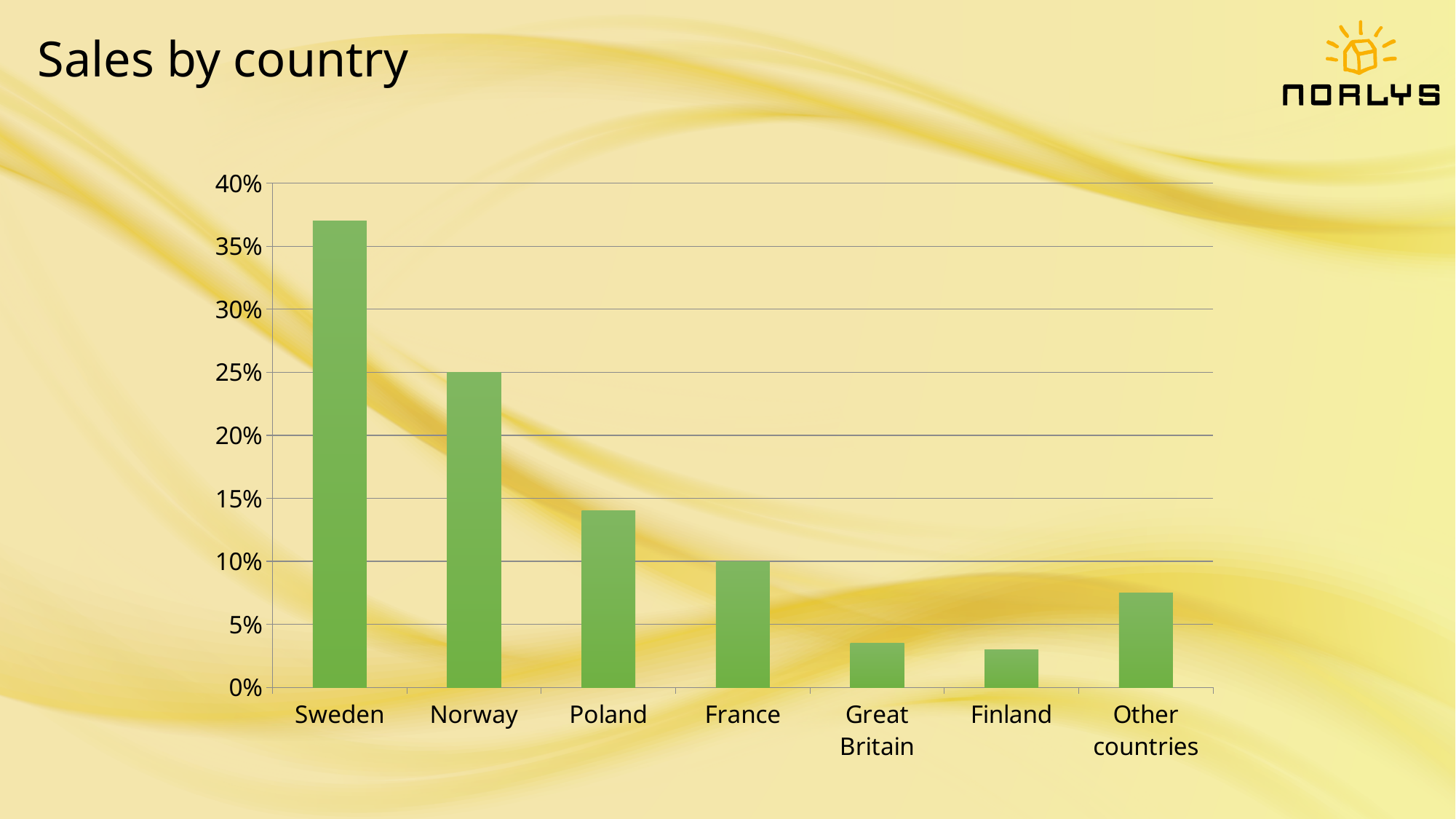
Is the value for Other countries greater or less than 5%? greater Is the value for Sweden greater or less than 35%? greater How many countries/categories are shown on the x axis? 7 What is the title of the chart? Sales by country What is the sales share for France? 10% Do the values generally rise or fall from Sweden to Finland along the x axis? fall Which is larger, the value for Poland or the value for France? Poland Which country has the highest sales share? Sweden Is the value for Poland greater or less than 15%? less What type of chart is shown on the slide? bar chart What is the sales share for Norway? 25%